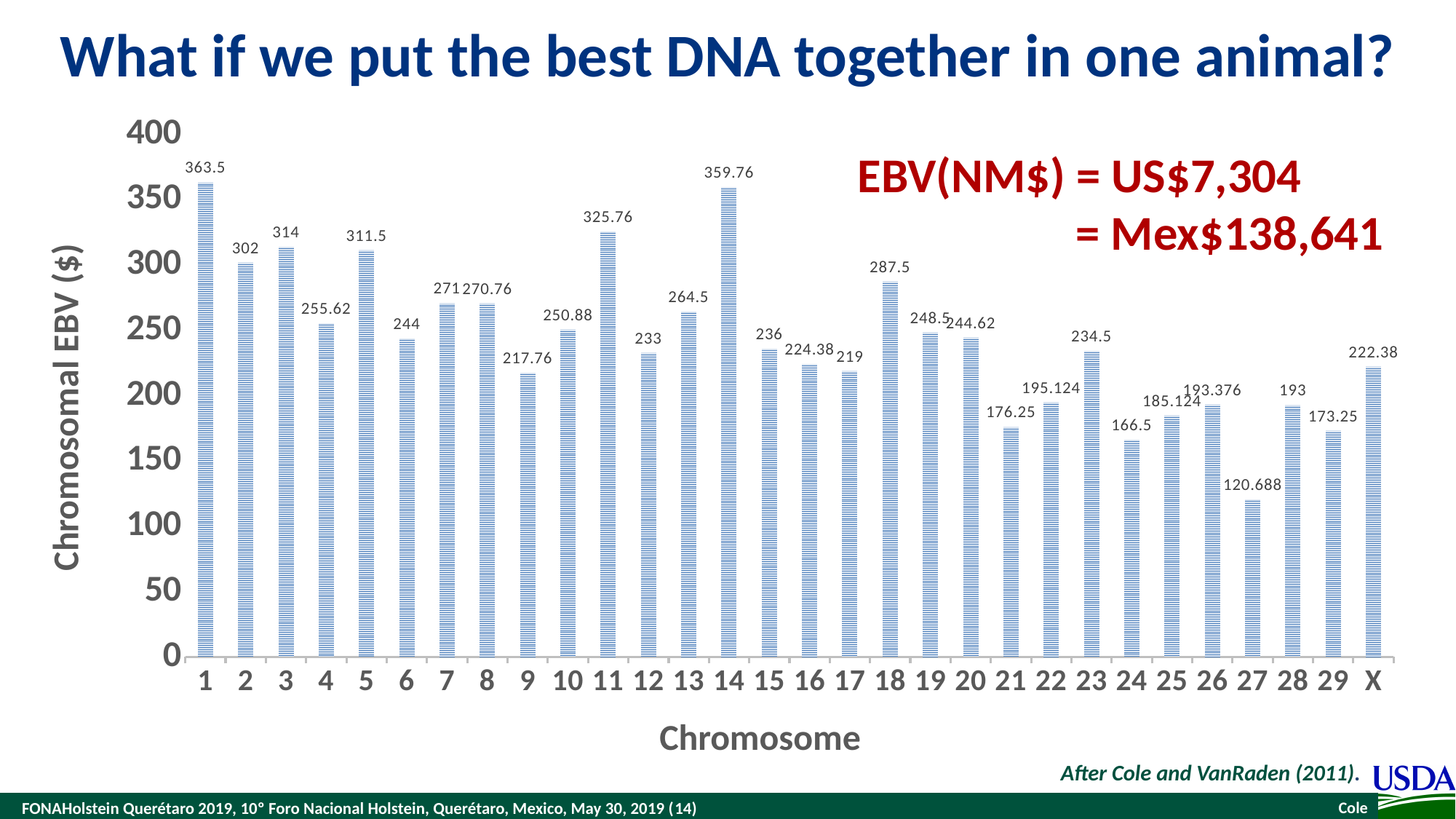
What kind of chart is shown on the slide? Bar chart What is the difference in chromosomal EBV ($) between chromosome 1 and chromosome 14? 3.74 What is the difference in chromosomal EBV ($) between chromosome 3 and chromosome 2? 12 What is the chromosomal EBV ($) for chromosome 11? 325.76 What is the chromosomal EBV ($) for chromosome 27? 120.688 Which chromosome has the lowest chromosomal EBV ($)? 27 What is the chromosomal EBV ($) for chromosome X? 222.38 How many chromosomes are shown on the x axis of the chart? 30 What is the label of the y axis of the chart? Chromosomal EBV ($) Which has a larger chromosomal EBV ($), chromosome 18 or chromosome 19? Chromosome 18 Which chromosome has the highest chromosomal EBV ($)? 1 Is the chromosomal EBV ($) for chromosome 24 greater or less than 200? less